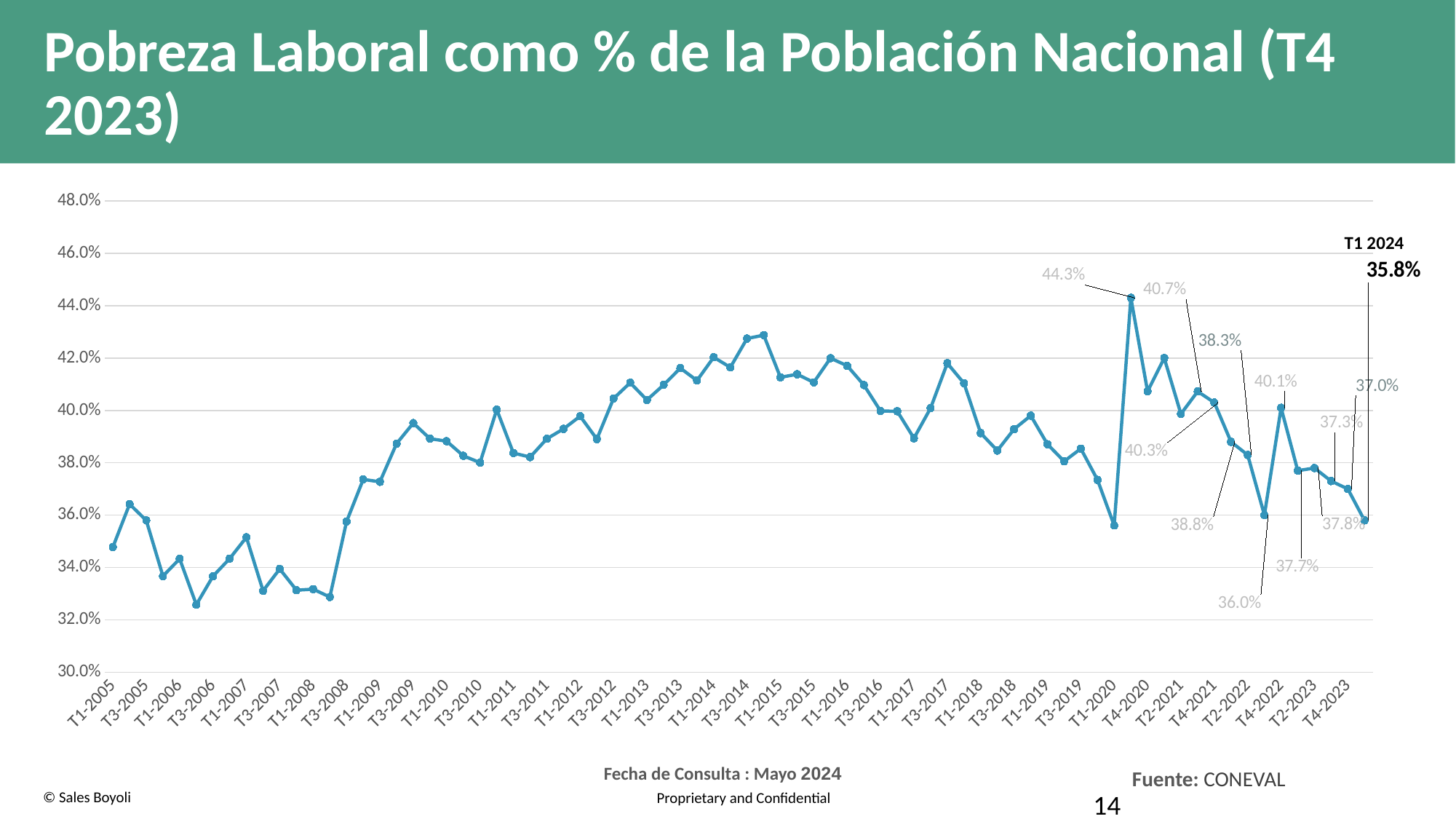
What is the value for T4-2022? 40.1% Which is larger, the value for T4-2022 (40.1%) or the value for T4-2023 (37.0%)? T4-2022 What source is cited for the chart data? CONEVAL What kind of chart is shown on the slide? line chart Is the value for T1-2005 greater or less than 36.0%? less What is the value for T4-2023? 37.0% Is the value for T3-2014 greater or less than 42.0%? greater What is the highest value shown on the chart, reached at the T3-2020 peak? 44.3% Do the values rise or fall from T4-2022 to T1 2024? fall What is the value labelled for T1 2024? 35.8% Is the value for T3-2008 greater or less than 34.0%? greater What is the difference between the peak value of 44.3% and the T1 2024 value of 35.8%? 8.5 percentage points